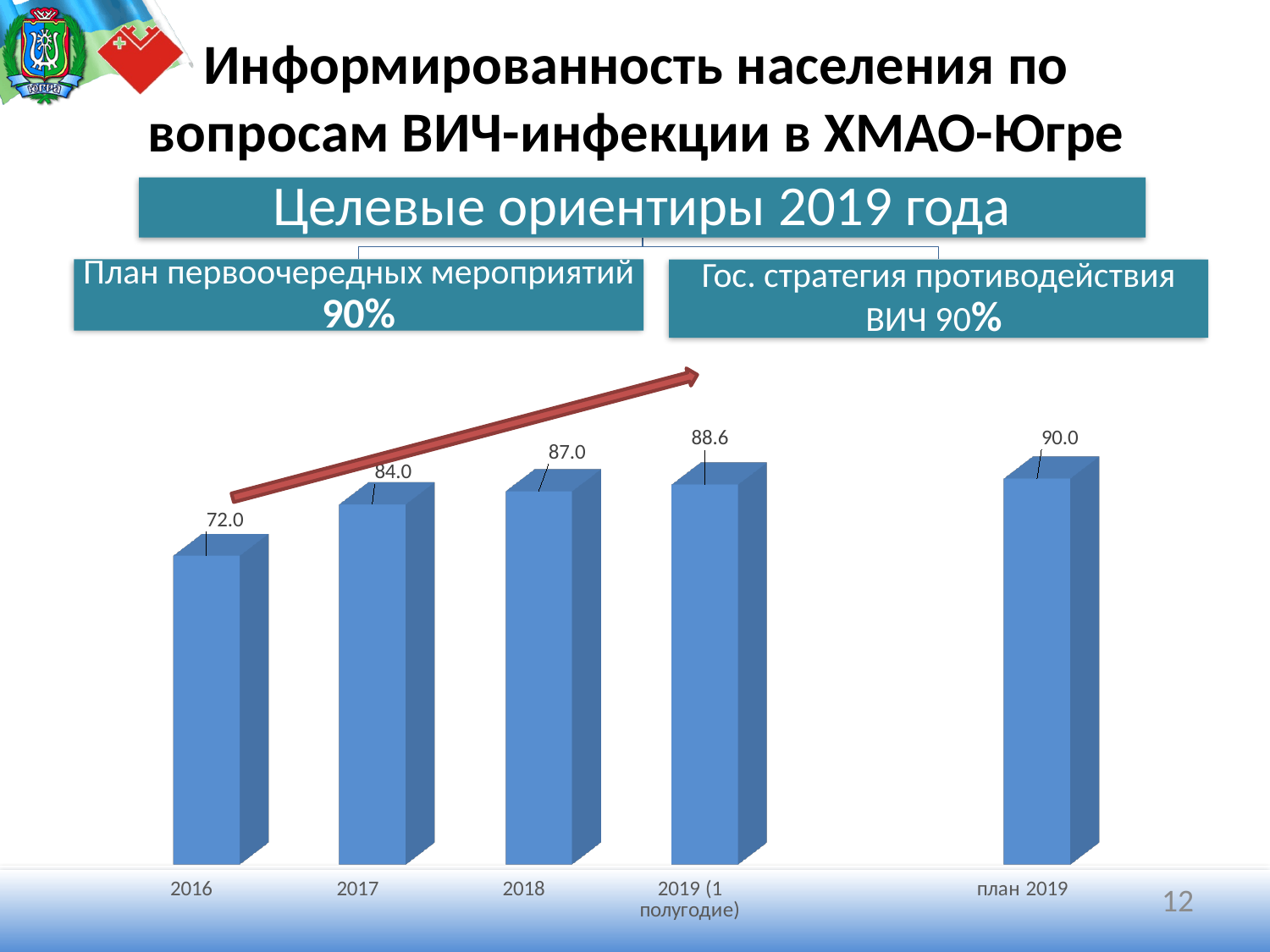
What is the difference between the values for 2017 and 2016? 12.0 What is the value for 2019 (1 полугодие)? 88.6 How many categories are shown on the x axis? 5 What kind of chart is shown on the slide? bar chart Which is larger, the value for 2018 or the value for 2017? 2018 What is the value for план 2019? 90.0 What is the value for 2017? 84.0 Which category has the highest value? план 2019 Which category has the lowest value? 2016 What is the value for 2016? 72.0 What is the value for 2018? 87.0 What is the difference between the values for план 2019 and 2019 (1 полугодие)? 1.4